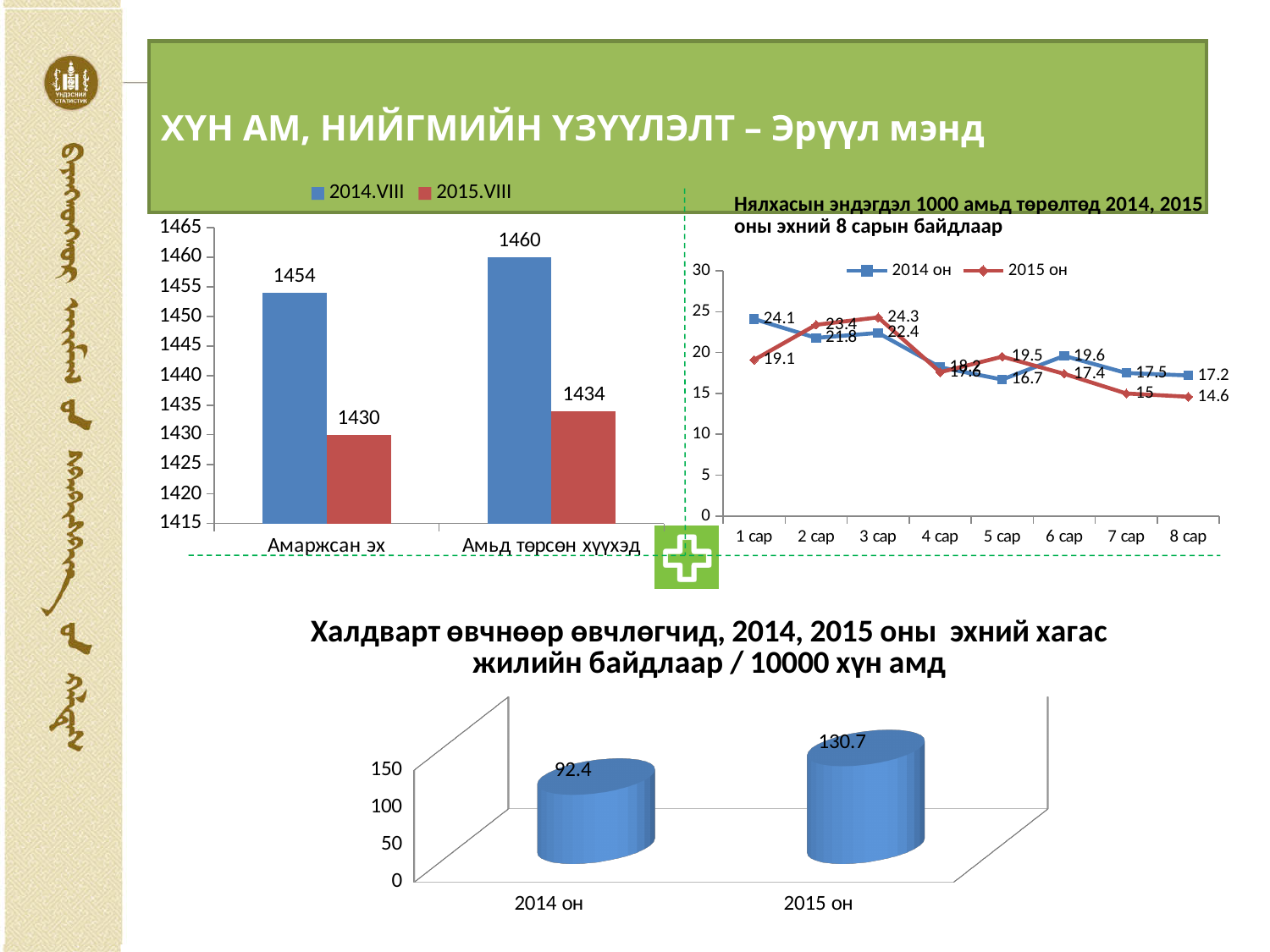
In the chart titled 'Халдварт өвчнөөр өвчлөгчид, 2014, 2015 оны эхний хагас жилийн байдлаар / 10000 хүн амд', what is the value for 2015 он? 130.7 In the chart titled 'Нялхасын эндэгдэл 1000 амьд төрөлтөд 2014, 2015 оны эхний 8 сарын байдлаар', which month has the lowest 2015 он value? 8 сар In the chart titled 'Халдварт өвчнөөр өвчлөгчид, 2014, 2015 оны эхний хагас жилийн байдлаар / 10000 хүн амд', what is the difference between the 2015 он and 2014 он values? 38.3 In the chart titled 'Нялхасын эндэгдэл 1000 амьд төрөлтөд 2014, 2015 оны эхний 8 сарын байдлаар', what is the 2014 он value for 1 сар? 24.1 In the top-left bar chart, what is the 2014.VIII value for Амаржсан эх? 1454 In the top-left bar chart, which series has the larger value for Амьд төрсөн хүүхэд, 2014.VIII or 2015.VIII? 2014.VIII What kind of chart is the chart titled 'Нялхасын эндэгдэл 1000 амьд төрөлтөд 2014, 2015 оны эхний 8 сарын байдлаар'? line chart In the top-left bar chart, what is the difference between the 2014.VIII and 2015.VIII values for Амаржсан эх? 24 In the chart titled 'Нялхасын эндэгдэл 1000 амьд төрөлтөд 2014, 2015 оны эхний 8 сарын байдлаар', how many months are shown on the x axis? 8 In the top-left bar chart, how many series does the legend list? 2 In the chart titled 'Нялхасын эндэгдэл 1000 амьд төрөлтөд 2014, 2015 оны эхний 8 сарын байдлаар', what is the 2015 он value for 3 сар? 24.3 In the top-left bar chart, what is the 2015.VIII value for Амьд төрсөн хүүхэд? 1434